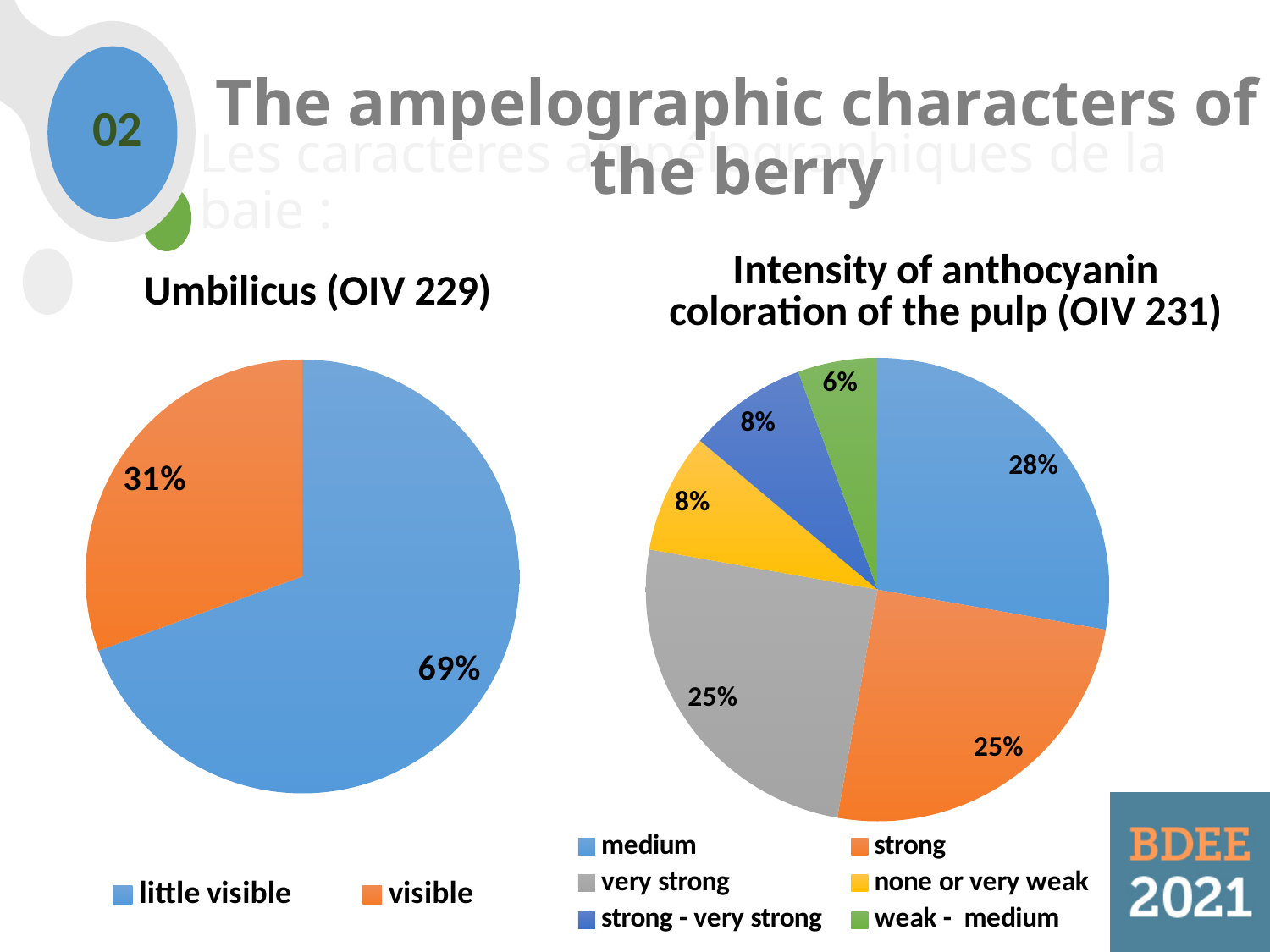
In the Intensity of anthocyanin coloration of the pulp (OIV 231) chart, what colour is the 'very strong' slice? gray In the Intensity of anthocyanin coloration of the pulp (OIV 231) chart, what share is 'weak - medium'? 6% In the Intensity of anthocyanin coloration of the pulp (OIV 231) chart, what is the difference between the 'medium' and 'strong' shares? 3% What kind of chart is the Umbilicus (OIV 229) chart? pie chart In the Intensity of anthocyanin coloration of the pulp (OIV 231) chart, which category has the largest share? medium In the Umbilicus (OIV 229) chart, what share of the pie is 'visible'? 31% How many categories does the legend of the Intensity of anthocyanin coloration of the pulp (OIV 231) chart list? 6 In the Intensity of anthocyanin coloration of the pulp (OIV 231) chart, which category has the smallest share? weak - medium In the Intensity of anthocyanin coloration of the pulp (OIV 231) chart, what share is 'medium'? 28% In the Umbilicus (OIV 229) chart, what is the difference between the 'little visible' and 'visible' shares? 38% In the Umbilicus (OIV 229) chart, which category has the larger share? little visible